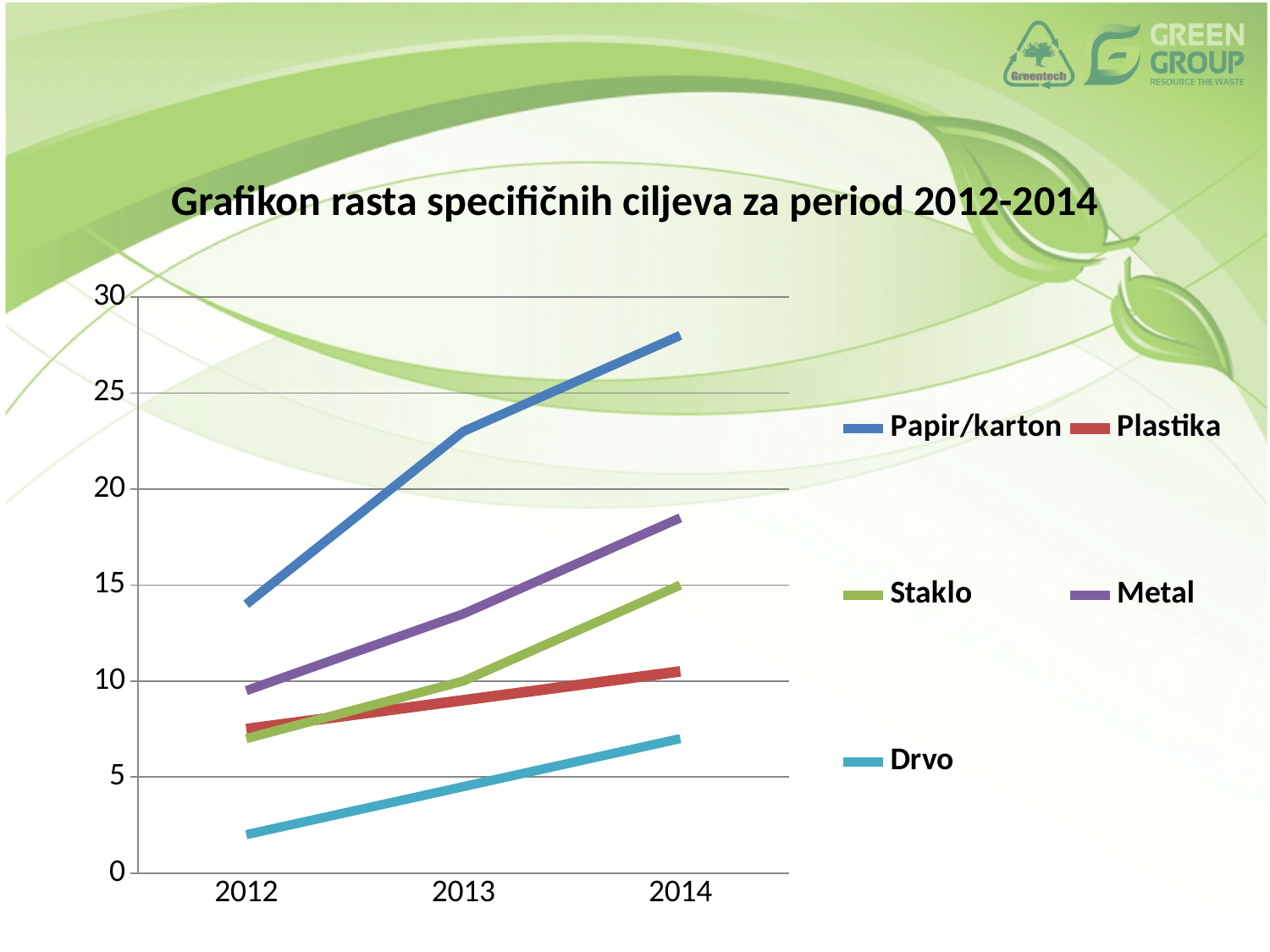
How many series does the legend list? 5 Is the value for Metal in 2014 greater or less than 15? greater Does the Papir/karton line rise or fall from 2012 to 2014? rise How many years are shown on the x axis? 3 Which is larger in 2014, Staklo or Plastika? Staklo Which series has the lowest value in 2014? Drvo Is the value for Papir/karton in 2012 greater or less than 15? less Which is larger in 2013, Metal or Staklo? Metal Is the value for Papir/karton in 2014 greater or less than 25? greater What kind of chart is shown on the slide? line chart What is the title of the chart? Grafikon rasta specifičnih ciljeva za period 2012-2014 Which series has the highest value in 2014? Papir/karton